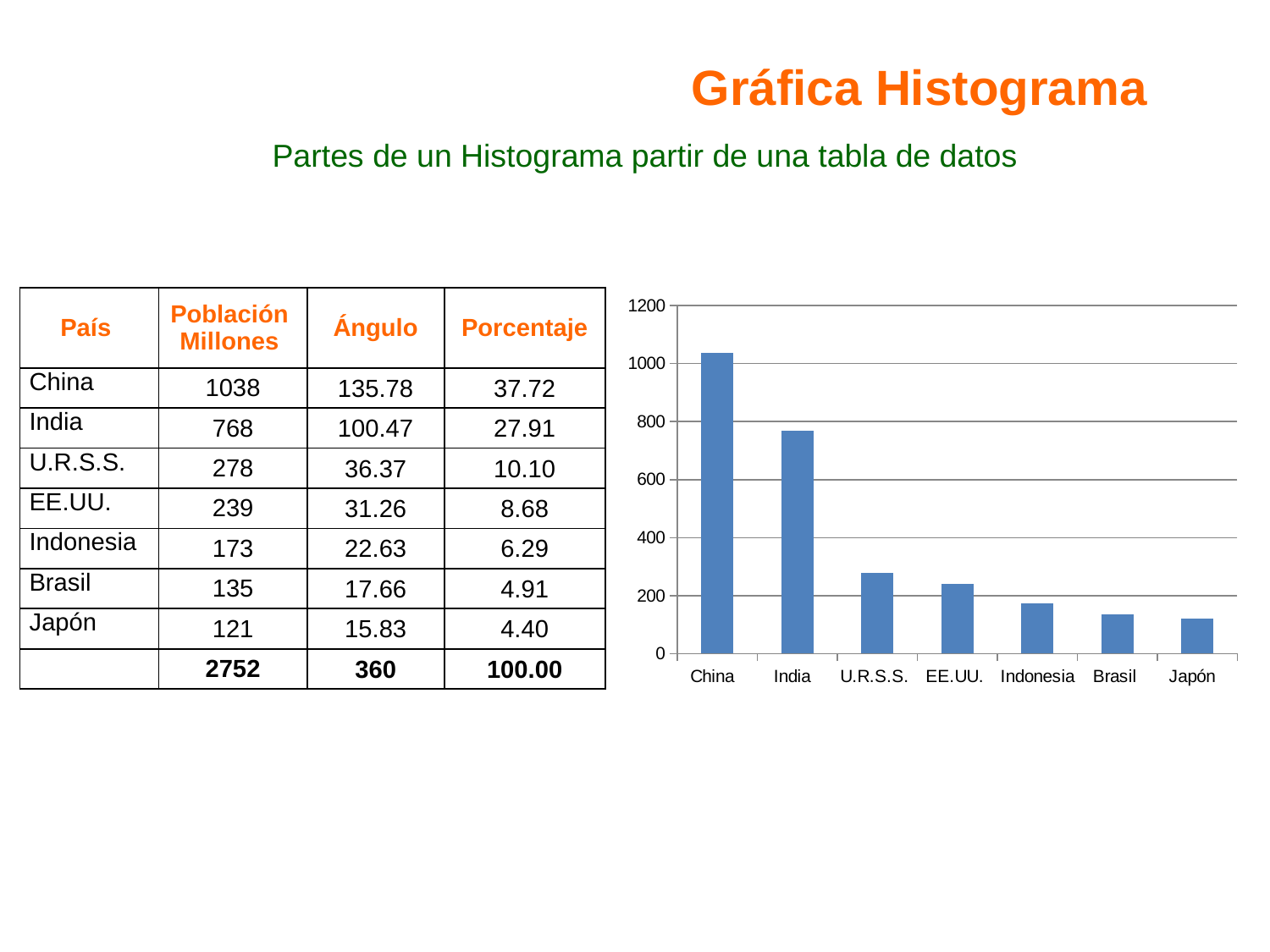
What kind of chart is shown on the slide? bar chart What is the population in millions plotted for China, as printed in the table on the slide? 1038 Which country has the lowest bar in the chart? Japón Do the bar values rise or fall from left to right along the x axis? fall Which country has the highest bar in the chart? China How many countries are plotted on the bar chart? 7 What is the difference between the population values for China and India, as printed in the table on the slide? 270 Is the value for U.R.S.S. greater or less than 200? greater Is the value for China greater or less than 1000? greater Is the value for Japón greater or less than 200? less Which is larger in the chart, the bar for EE.UU. or the bar for Indonesia? EE.UU.